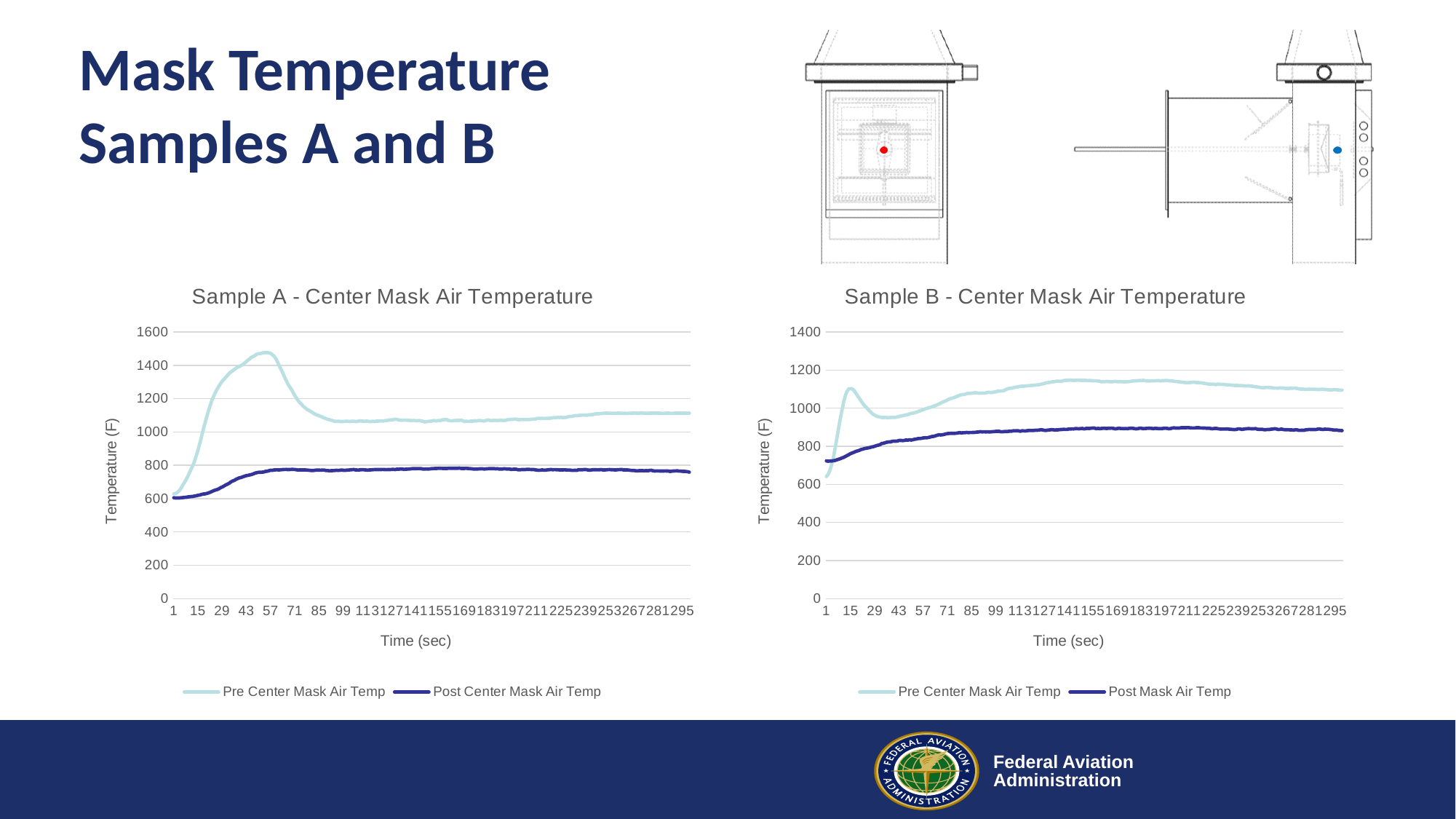
In "Sample A - Center Mask Air Temperature", is the Post Center Mask Air Temp line ever greater or less than 800 across the whole time range? less In "Sample B - Center Mask Air Temperature", which series is higher at time 141, Pre Center Mask Air Temp or Post Mask Air Temp? Pre Center Mask Air Temp In "Sample B - Center Mask Air Temperature", does the Post Mask Air Temp line rise or fall from time 1 to time 295? rise In "Sample A - Center Mask Air Temperature", is the peak value of Pre Center Mask Air Temp greater or less than 1400? greater What is the y-axis title of "Sample A - Center Mask Air Temperature"? Temperature (F) What is the highest tick value shown on the y-axis of "Sample B - Center Mask Air Temperature"? 1400 In "Sample A - Center Mask Air Temperature", which series is higher at time 295, Pre Center Mask Air Temp or Post Center Mask Air Temp? Pre Center Mask Air Temp How many series does the legend of "Sample B - Center Mask Air Temperature" list? 2 In "Sample B - Center Mask Air Temperature", is the Pre Center Mask Air Temp value at time 1 greater or less than 800? less What kind of chart is "Sample A - Center Mask Air Temperature"? line chart